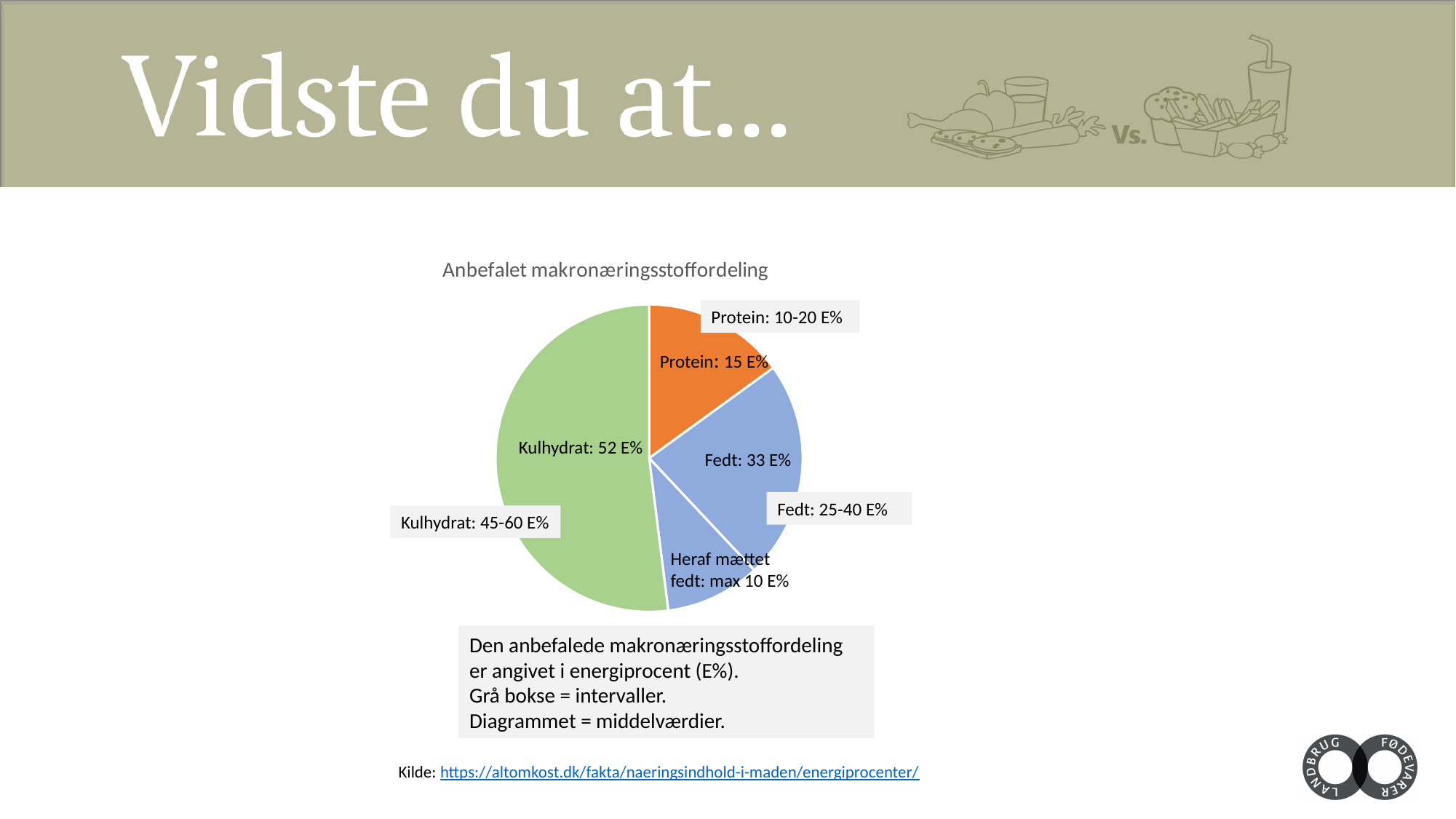
What interval is given in the grey box for Protein? 10-20 E% What kind of chart is shown on the slide? Pie chart What value is shown for Kulhydrat in the pie chart? 52 E% Which macronutrient has the largest slice in the pie chart? Kulhydrat What value is shown for Protein in the pie chart? 15 E% What is the difference between the Kulhydrat value and the Fedt value in the pie chart? 19 E% What is the title of the pie chart? Anbefalet makronæringsstoffordeling What interval is given in the grey box for Kulhydrat? 45-60 E% What value is shown for Fedt in the pie chart? 33 E% Of the three macronutrients Protein, Fedt and Kulhydrat, which has the smallest slice? Protein Which is larger in the pie chart, Fedt or Protein? Fedt What is the maximum value given for 'Heraf mættet fedt' in the pie chart? max 10 E%